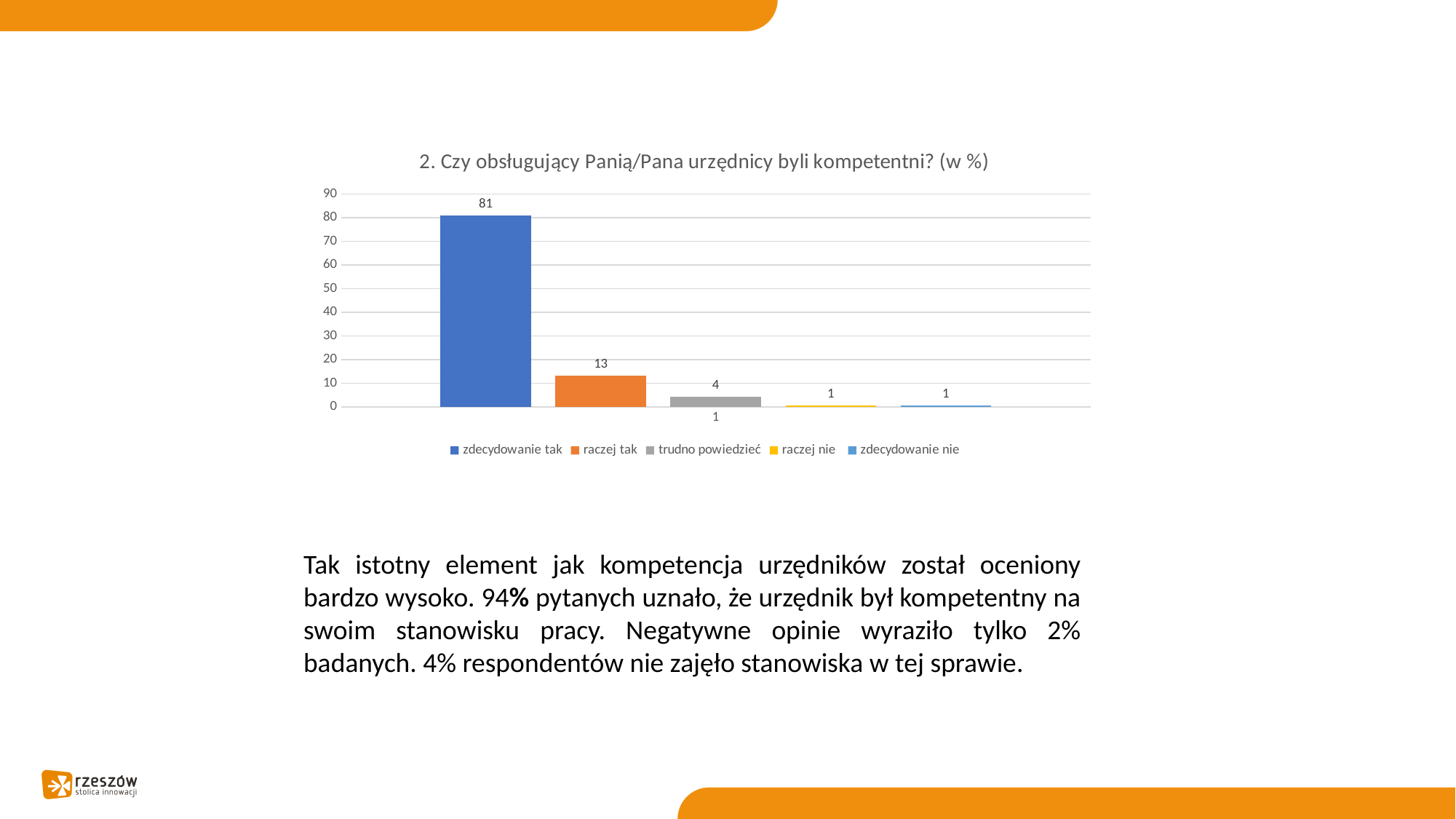
What is the difference between the values for "zdecydowanie tak" and "raczej tak"? 68 What is the difference between the values for "raczej tak" and "trudno powiedzieć"? 9 What value is shown for "raczej tak"? 13 How many series does the legend list? 5 Which is larger, the value for "raczej tak" or the value for "trudno powiedzieć"? raczej tak What value is shown for "raczej nie"? 1 What is the title of the chart? 2. Czy obsługujący Panią/Pana urzędnicy byli kompetentni? (w %) What value is shown for "zdecydowanie tak"? 81 Is the value for "zdecydowanie tak" greater or less than 80? greater Which series has the highest value? zdecydowanie tak What kind of chart is shown on the slide? bar chart What value is shown for "trudno powiedzieć"? 4